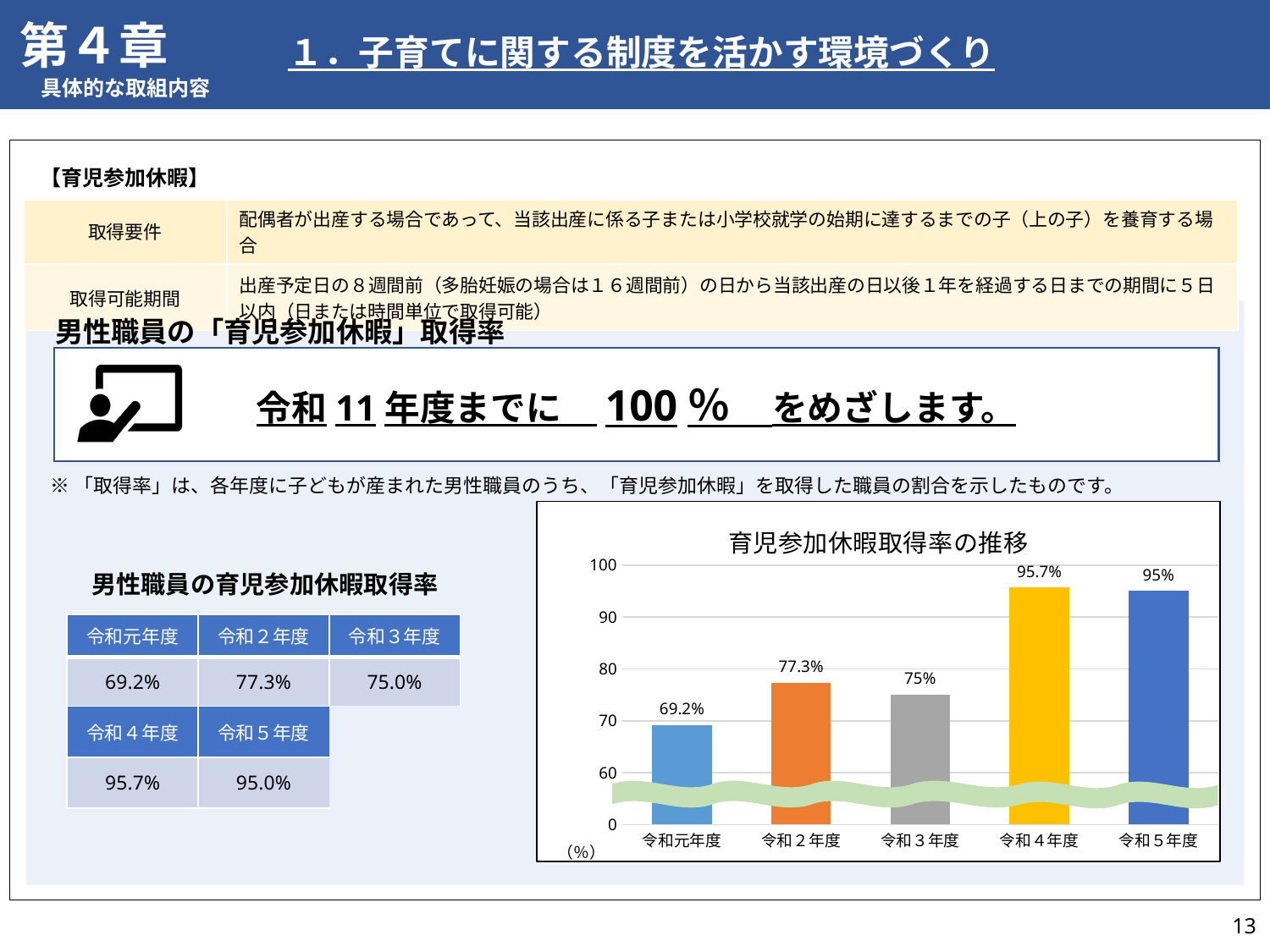
What is the value for 令和４年度 in the chart 育児参加休暇取得率の推移? 95.7% What is the title of the chart on the slide? 育児参加休暇取得率の推移 In the chart 育児参加休暇取得率の推移, what is the difference between the values for 令和４年度 and 令和元年度? 26.5% In the chart 育児参加休暇取得率の推移, which is larger, the value for 令和２年度 or 令和３年度? 令和２年度 What kind of chart is 育児参加休暇取得率の推移? bar chart Which year has the highest value in the chart 育児参加休暇取得率の推移? 令和４年度 What is the value for 令和２年度 in the chart 育児参加休暇取得率の推移? 77.3% What is the value for 令和元年度 in the chart 育児参加休暇取得率の推移? 69.2% What is the value for 令和５年度 in the chart 育児参加休暇取得率の推移? 95% How many years are plotted in the chart 育児参加休暇取得率の推移? 5 Which year has the lowest value in the chart 育児参加休暇取得率の推移? 令和元年度 What is the value for 令和３年度 in the chart 育児参加休暇取得率の推移? 75%